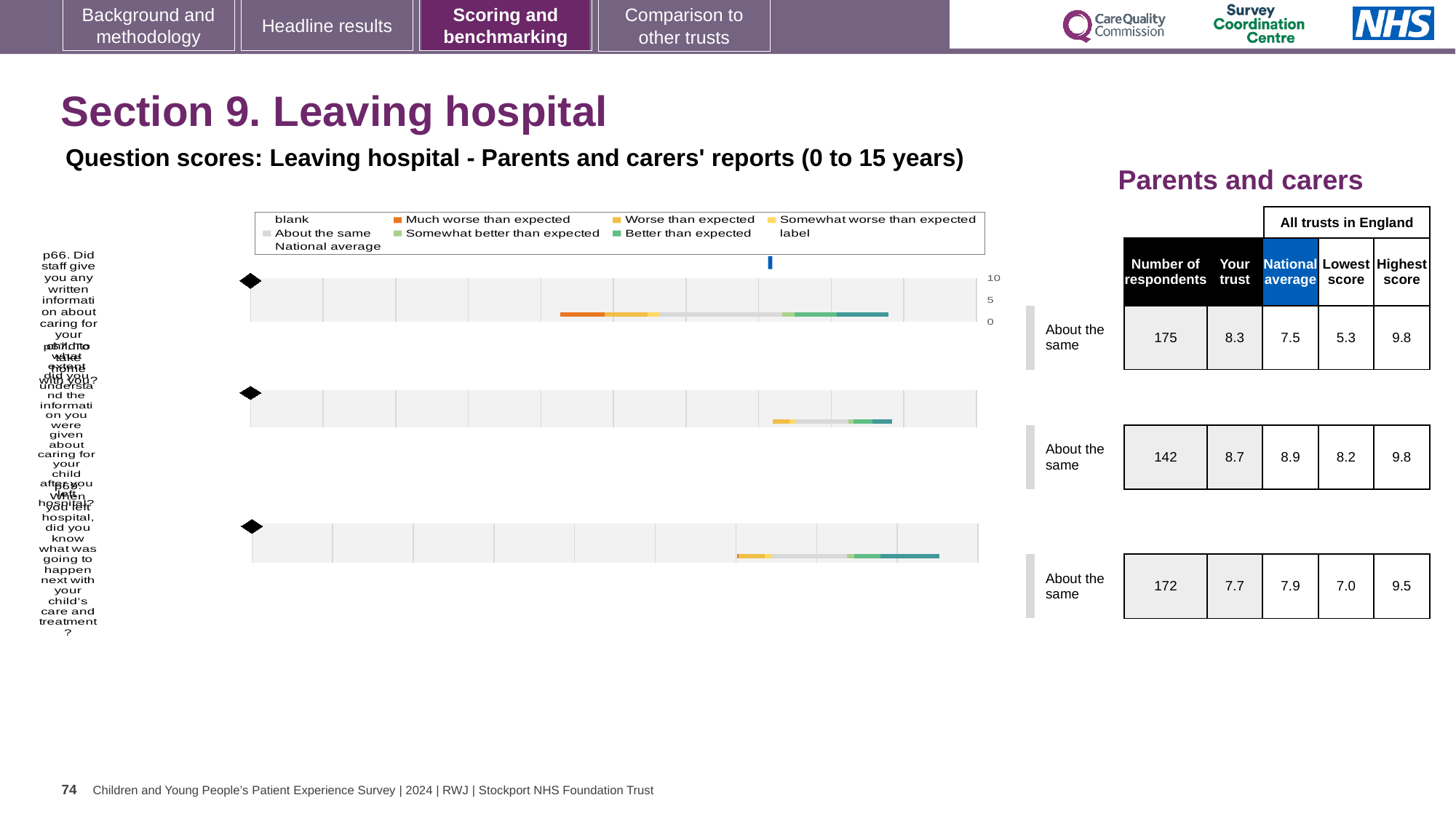
For the first chart row (p66), what is the 'Your trust' score shown in the table? 8.3 How many separate benchmark charts are shown on the slide? 3 For the first chart row (p66), what is the difference between the 'Your trust' score and the national average? 0.8 For the first chart row (p66), which is larger: the 'Your trust' score or the national average? Your trust Which of the three chart rows has the lowest 'Your trust' score? p68 (third row) What benchmark category is shown beside each of the three chart rows? About the same What kind of chart is used for the benchmark rows on the slide? bar chart Which legend entry is shown in light grey? About the same For the second chart row (p67), what is the number of respondents shown in the table? 142 For the third chart row (p68), what is the highest score across all trusts in England? 9.5 For the first chart row (p66), what is the national average shown in the table? 7.5 Which legend entry is shown in dark orange? Much worse than expected